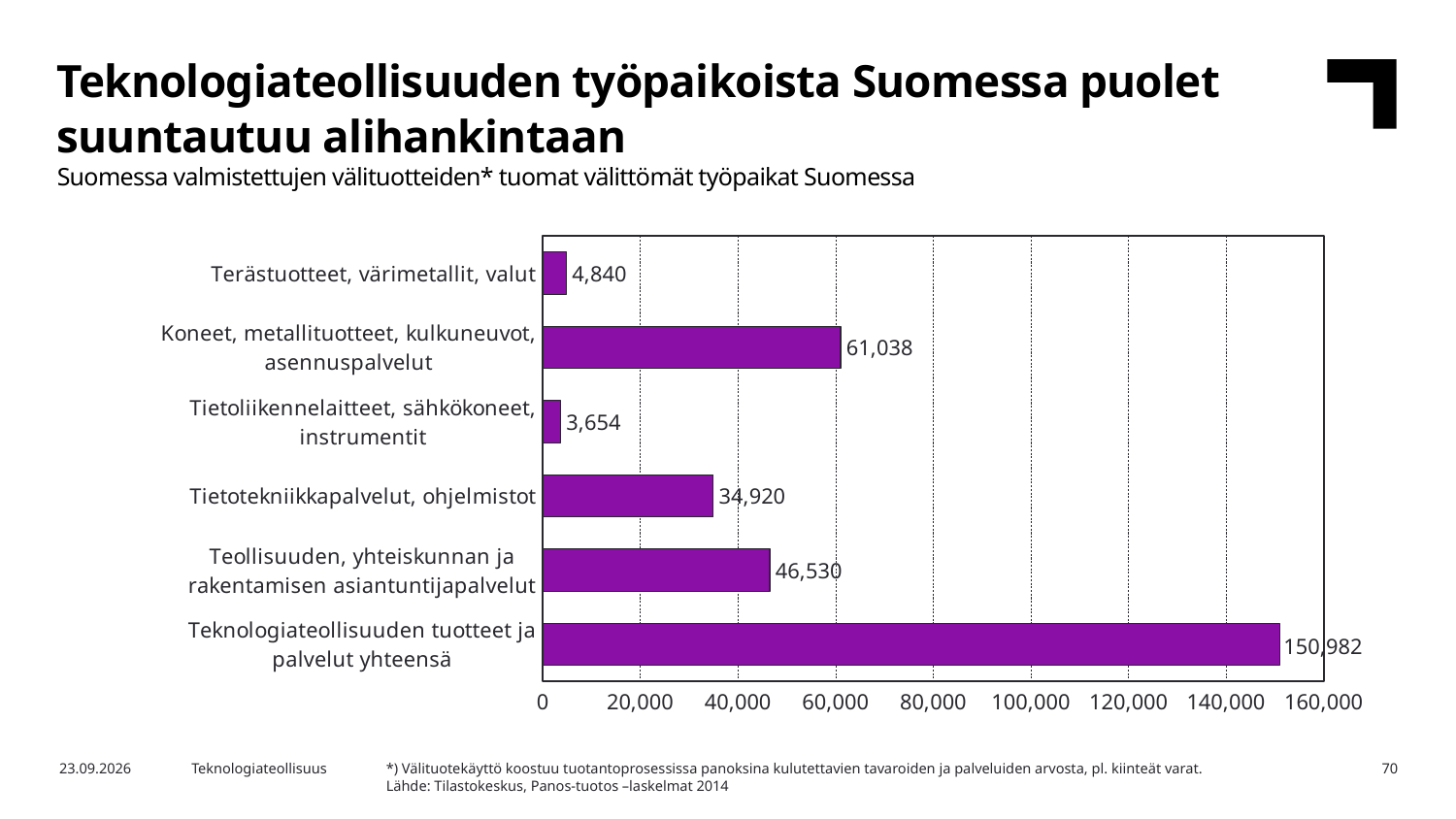
Which category has the lowest value? Tietoliikennelaitteet, sähkökoneet, instrumentit What is the value for Teknologiateollisuuden tuotteet ja palvelut yhteensä? 150,982 Which category has the highest value? Teknologiateollisuuden tuotteet ja palvelut yhteensä What is the value for Koneet, metallituotteet, kulkuneuvot, asennuspalvelut? 61,038 What is the value for Tietotekniikkapalvelut, ohjelmistot? 34,920 What kind of chart is shown on the slide? Bar chart Which is larger: the value for Teollisuuden, yhteiskunnan ja rakentamisen asiantuntijapalvelut or the value for Tietotekniikkapalvelut, ohjelmistot? Teollisuuden, yhteiskunnan ja rakentamisen asiantuntijapalvelut How many categories are shown in the chart? 6 Is the value for Koneet, metallituotteet, kulkuneuvot, asennuspalvelut greater or less than 60,000? greater What is the difference between the values for Terästuotteet, värimetallit, valut and Tietoliikennelaitteet, sähkökoneet, instrumentit? 1,186 What is the difference between the values for Koneet, metallituotteet, kulkuneuvot, asennuspalvelut and Tietotekniikkapalvelut, ohjelmistot? 26,118 What is the value for Tietoliikennelaitteet, sähkökoneet, instrumentit? 3,654